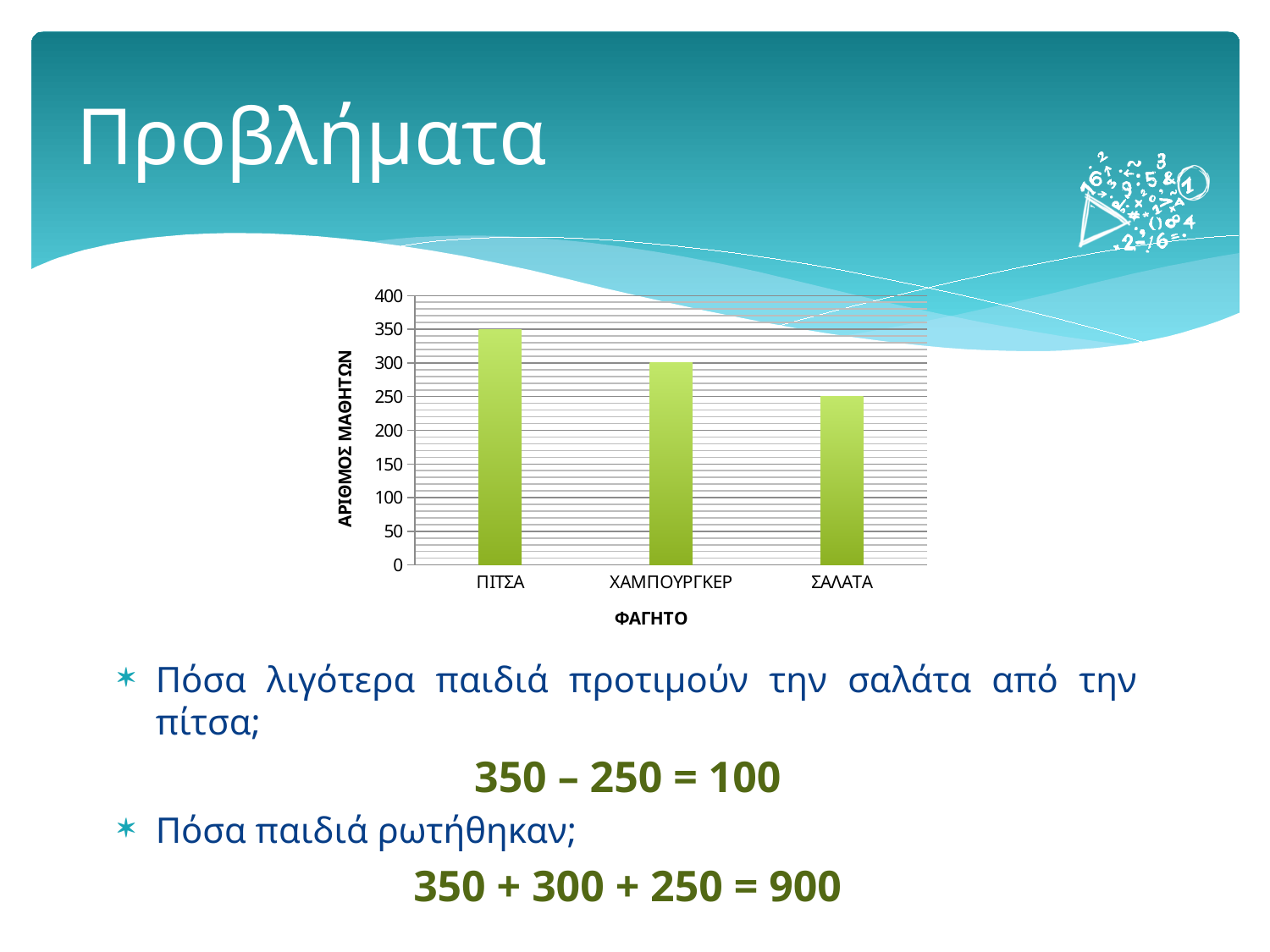
What kind of chart is shown on the slide? bar chart What is the label of the vertical axis of the chart? ΑΡΙΘΜΟΣ ΜΑΘΗΤΩΝ Is the value for ΧΑΜΠΟΥΡΓΚΕΡ greater or less than 200? greater What is the value for ΣΑΛΑΤΑ? 250 Which category has the lowest value? ΣΑΛΑΤΑ How many categories are shown on the x axis of the chart? 3 Which is larger, the value for ΧΑΜΠΟΥΡΓΚΕΡ or the value for ΣΑΛΑΤΑ? ΧΑΜΠΟΥΡΓΚΕΡ Do the values rise or fall from left to right along the x axis? fall What is the value for ΠΙΤΣΑ? 350 What is the value for ΧΑΜΠΟΥΡΓΚΕΡ? 300 Which category has the highest value? ΠΙΤΣΑ What is the difference between the values for ΠΙΤΣΑ and ΣΑΛΑΤΑ? 100